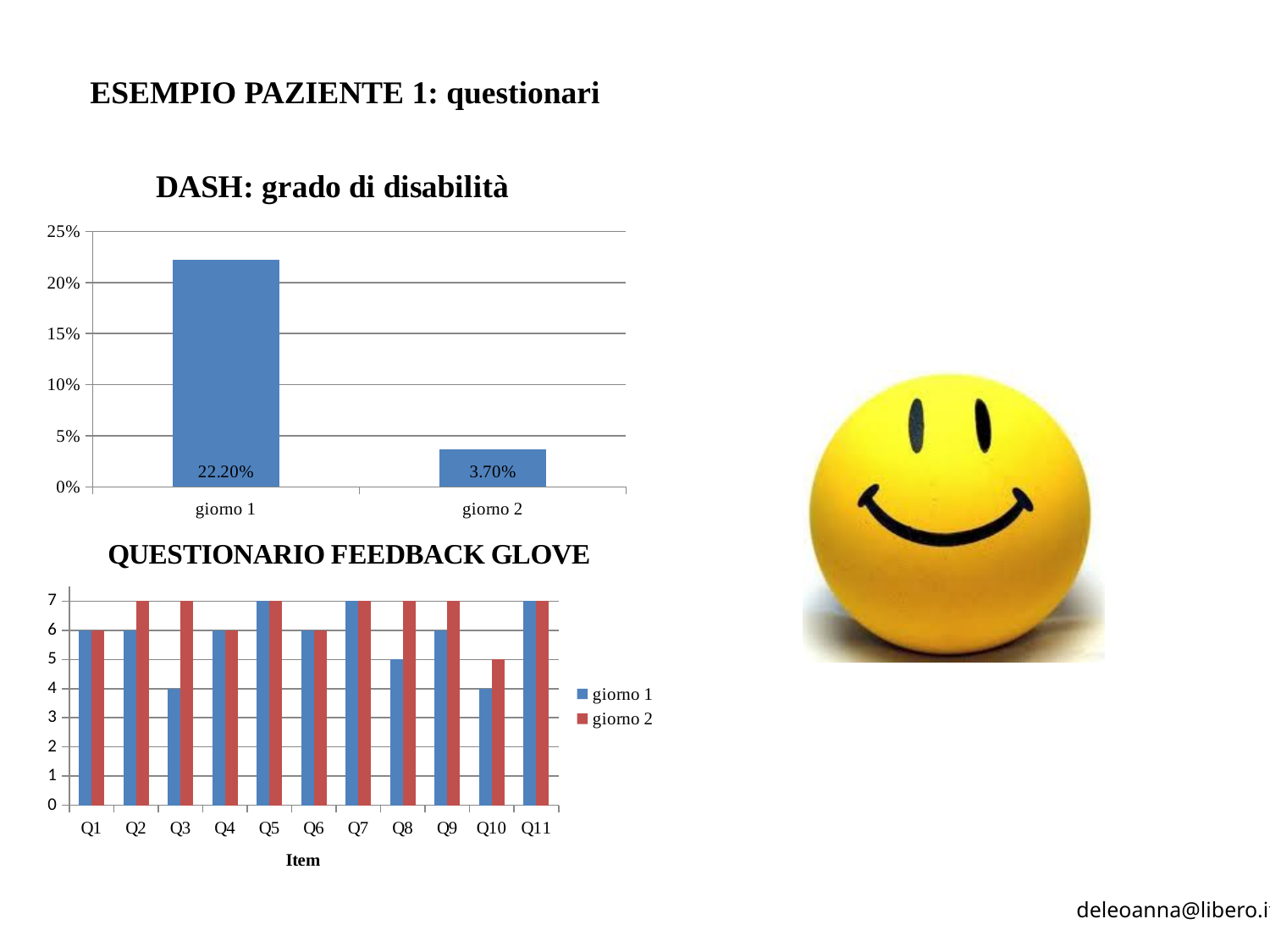
In the DASH: grado di disabilità chart, which category has the higher value? giorno 1 In the DASH: grado di disabilità chart, what is the value for giorno 2? 3.70% In the QUESTIONARIO FEEDBACK GLOVE chart, what is the giorno 1 value for Q3? 4 What is the x-axis title of the QUESTIONARIO FEEDBACK GLOVE chart? Item How many series does the legend of the QUESTIONARIO FEEDBACK GLOVE chart list? 2 In the QUESTIONARIO FEEDBACK GLOVE chart, which is larger for Q8: giorno 1 or giorno 2? giorno 2 What kind of chart is the QUESTIONARIO FEEDBACK GLOVE chart? bar chart In the QUESTIONARIO FEEDBACK GLOVE chart, what is the giorno 2 value for Q10? 5 In the DASH: grado di disabilità chart, what is the value for giorno 1? 22.20% In the DASH: grado di disabilità chart, is the value for giorno 1 greater or less than 20%? greater In the DASH: grado di disabilità chart, what is the difference between giorno 1 and giorno 2? 18.50% How many items are shown on the x axis of the QUESTIONARIO FEEDBACK GLOVE chart? 11